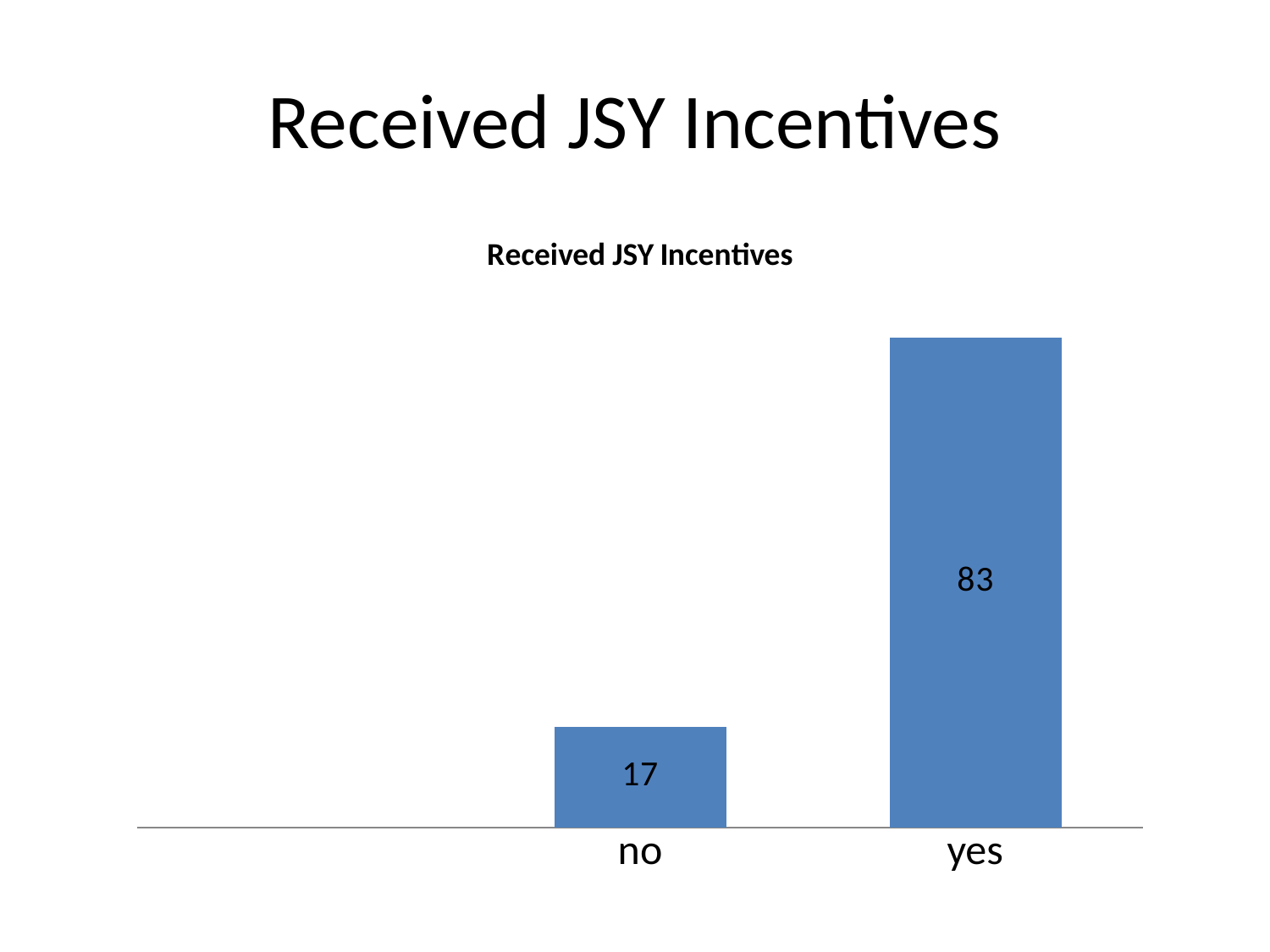
What is the total of the values for "no" and "yes"? 100 Which category has the lowest value? no Which category has the highest value? yes What is the title of the chart? Received JSY Incentives What is the difference between the values for "yes" and "no"? 66 How many categories are shown in the chart? 2 What colour are the bars in the chart? blue Which is larger, the value for "yes" or the value for "no"? yes What is the value for "yes"? 83 What is the value for "no"? 17 What kind of chart is shown on the slide? bar chart